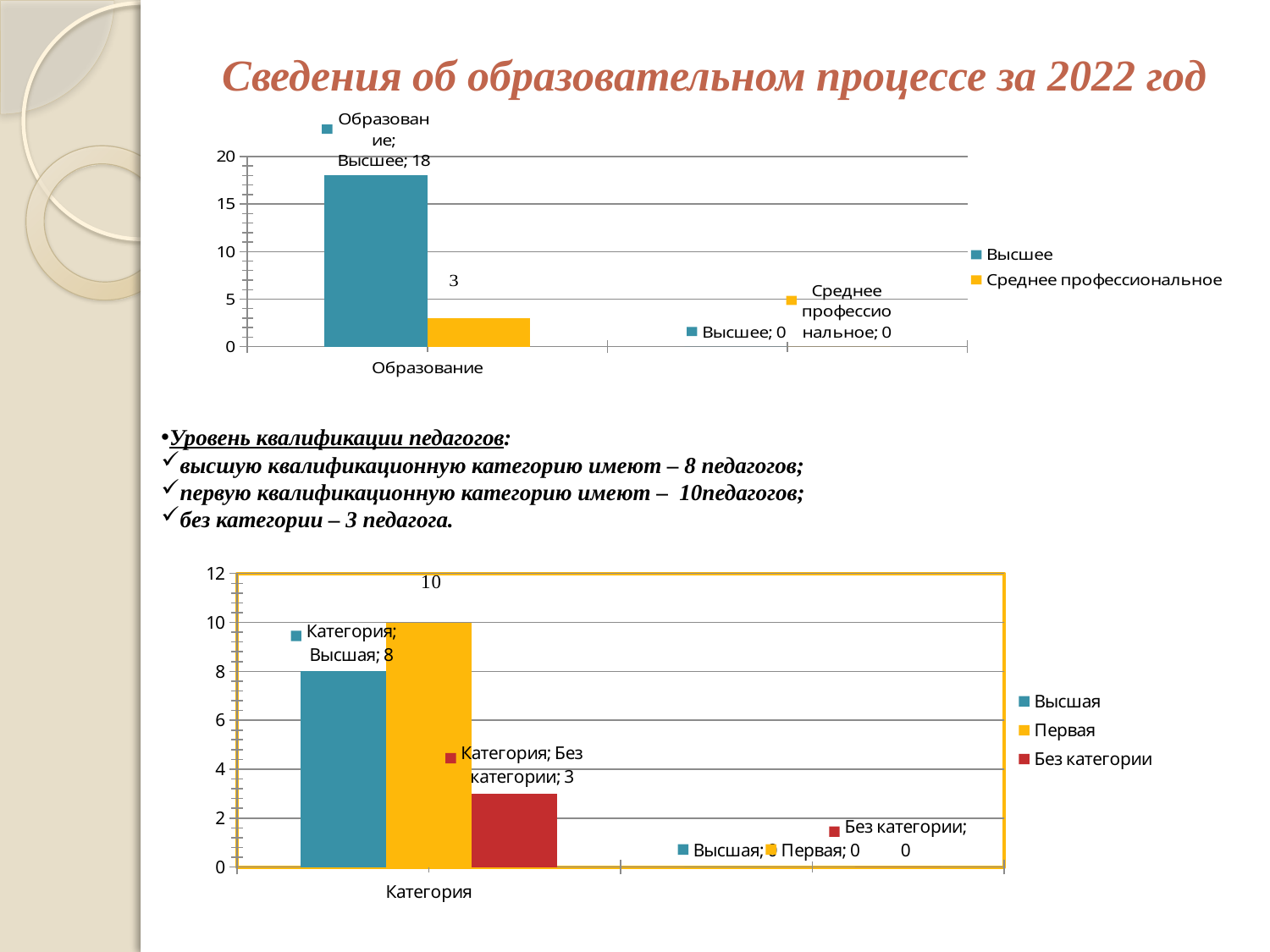
In the bottom chart, which series has the lowest value? Без категории In the bottom chart, how many series does the legend list? 3 In the top chart, how many series does the legend list? 2 In the bottom chart, what is the value for Первая? 10 In the bottom chart, what is the value for Без категории? 3 In the bottom chart, what is the value for Высшая? 8 What kind of chart is the top chart? Bar chart In the top chart, which series has the higher value, Высшее or Среднее профессиональное? Высшее In the top chart, what is the difference between Высшее and Среднее профессиональное? 15 In the bottom chart, which series has the highest value? Первая In the top chart, what is the value for Высшее? 18 In the top chart, what is the value for Среднее профессиональное? 3